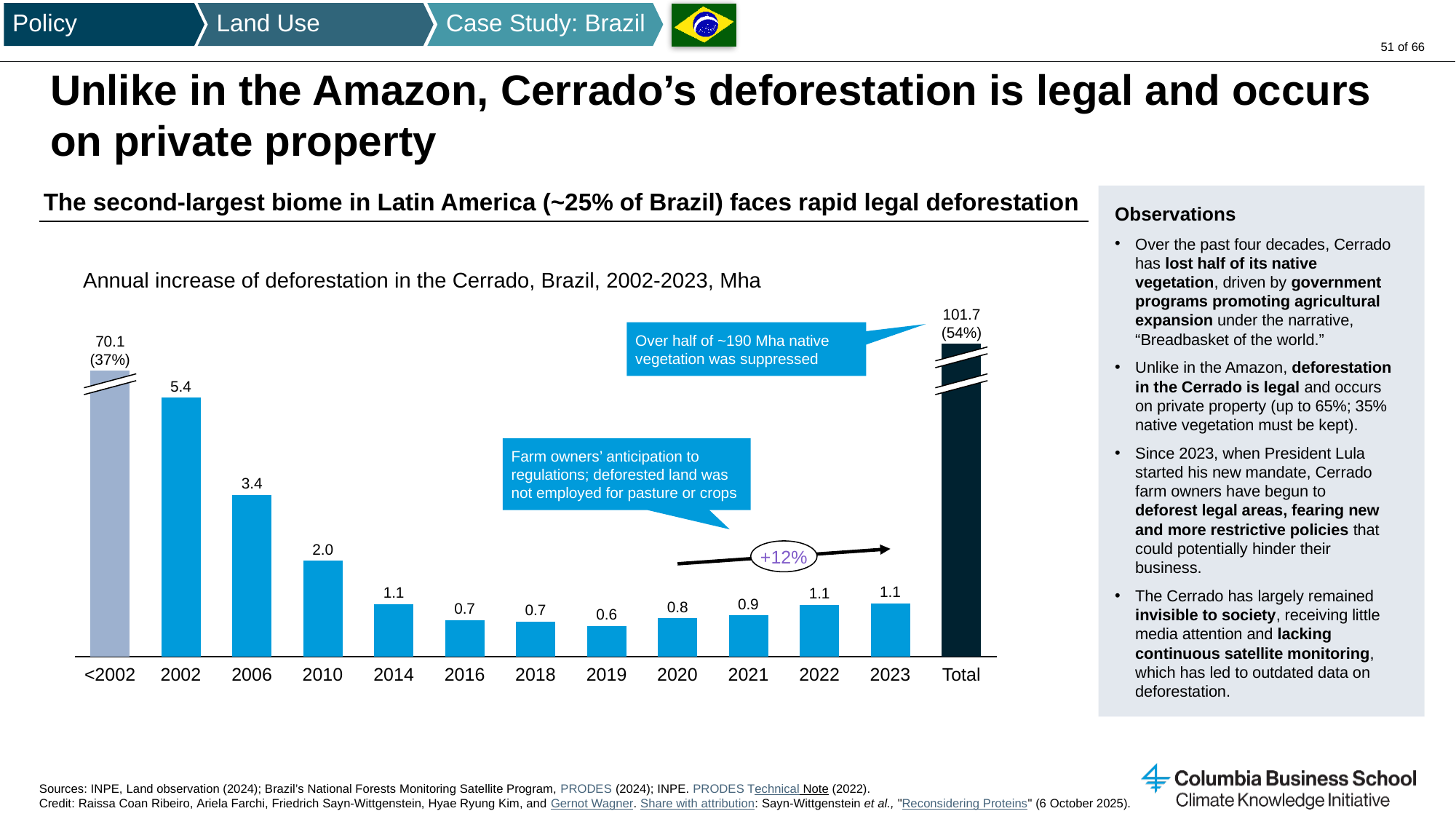
Excluding the <2002 and Total bars, which year has the highest value? 2002 What is the difference between the values for 2002 and 2006? 2.0 How many bars are shown in the chart, including <2002 and Total? 13 What value is shown for the Total bar? 101.7 What is the value for 2019? 0.6 Which year has the lowest value in the chart? 2019 What is the value for 2002 in the chart 'Annual increase of deforestation in the Cerrado, Brazil, 2002-2023, Mha'? 5.4 What kind of chart is shown on the slide? Bar chart Which is larger, the value for 2010 or the value for 2014? 2010 Do the values rise or fall from 2019 to 2023? Rise What percentage is shown in parentheses next to the Total bar? 54% What is the value shown for the <2002 bar? 70.1